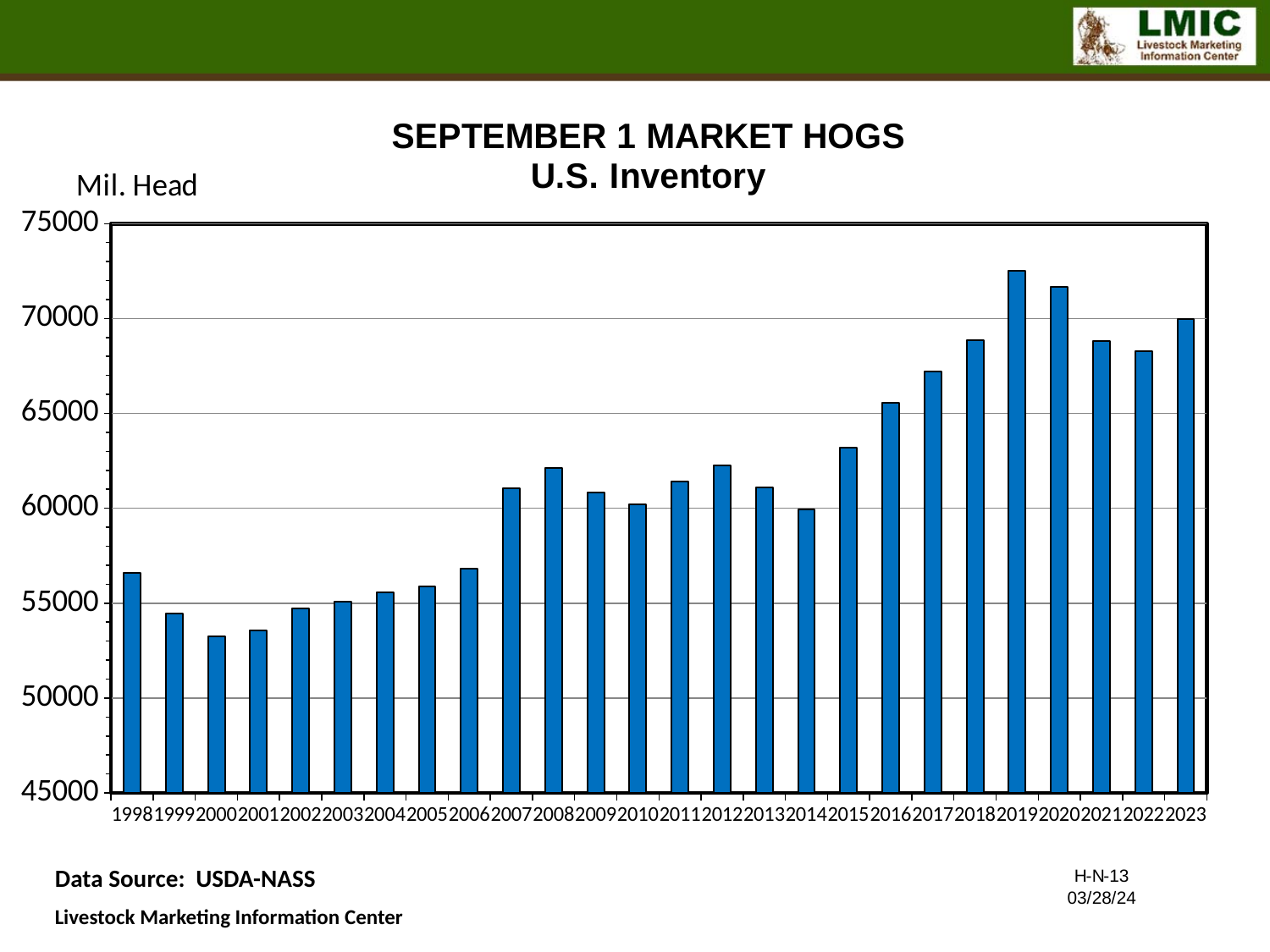
Which is larger, the value for 2019 or the value for 2020? 2019 What kind of chart is shown on the slide? bar chart Is the value for 2017 greater or less than 65000? greater Is the value for 2006 greater or less than 55000? greater Which is larger, the value for 2015 or the value for 2016? 2016 Is the value for 2000 greater or less than 55000? less Overall, do the values rise or fall from 1998 to 2023? rise How many years are plotted on the x axis of the chart? 26 Which year has the highest September 1 market hog inventory? 2019 What unit label is shown on the y axis of the chart? Mil. Head